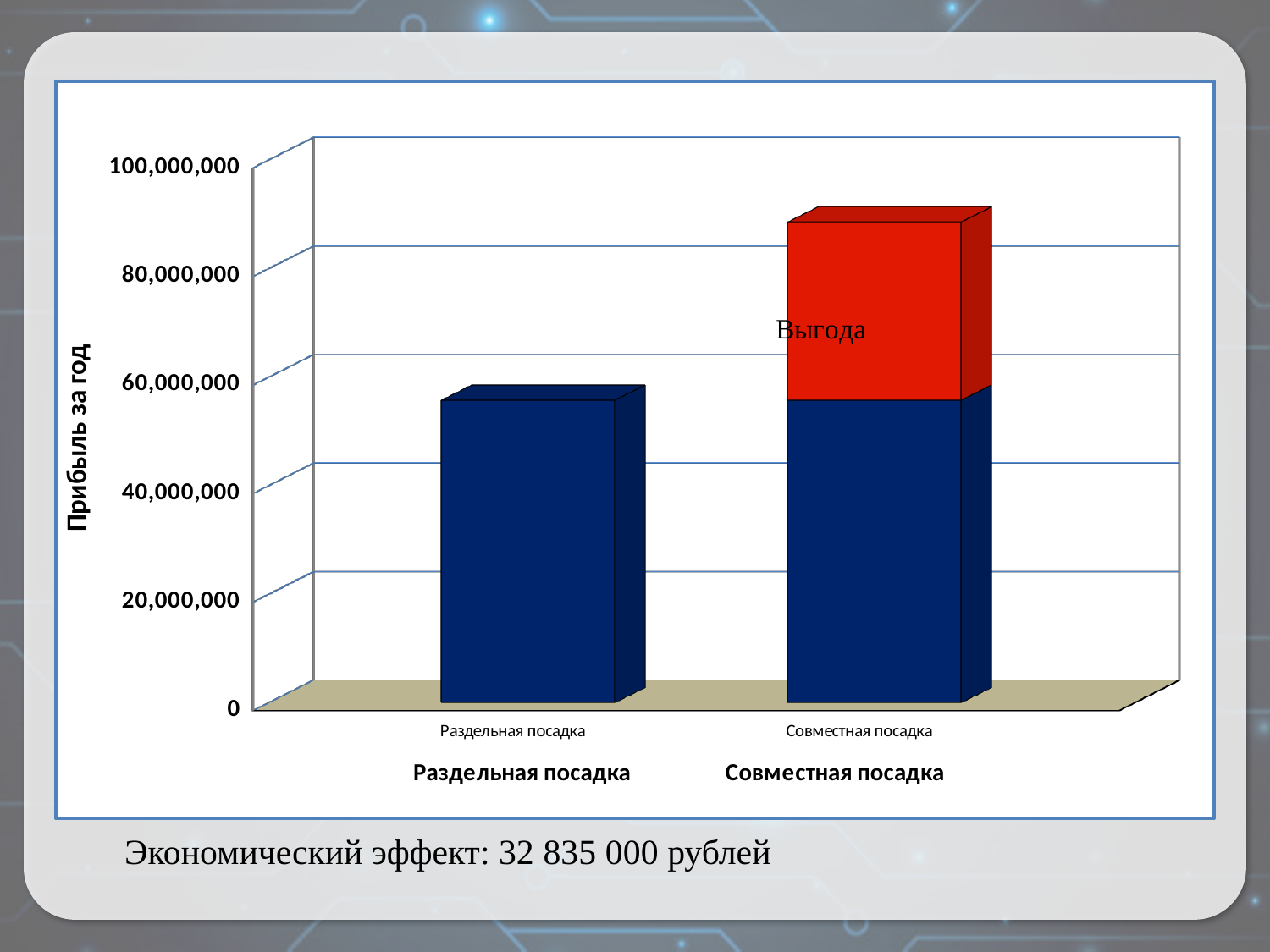
What label is written on the red segment of the Совместная посадка bar? Выгода Which category has the taller bar, Раздельная посадка or Совместная посадка? Совместная посадка Which category has the highest total bar in the chart? Совместная посадка What kind of chart is shown on the slide? bar chart Is the value for Раздельная посадка greater or less than 60,000,000? less Is the value for Раздельная посадка greater or less than 40,000,000? greater Is the total bar for Совместная посадка greater or less than 100,000,000? less What is the title of the vertical axis of the chart? Прибыль за год How many categories are shown on the x axis of the chart? 2 Which category has the lowest bar in the chart? Раздельная посадка